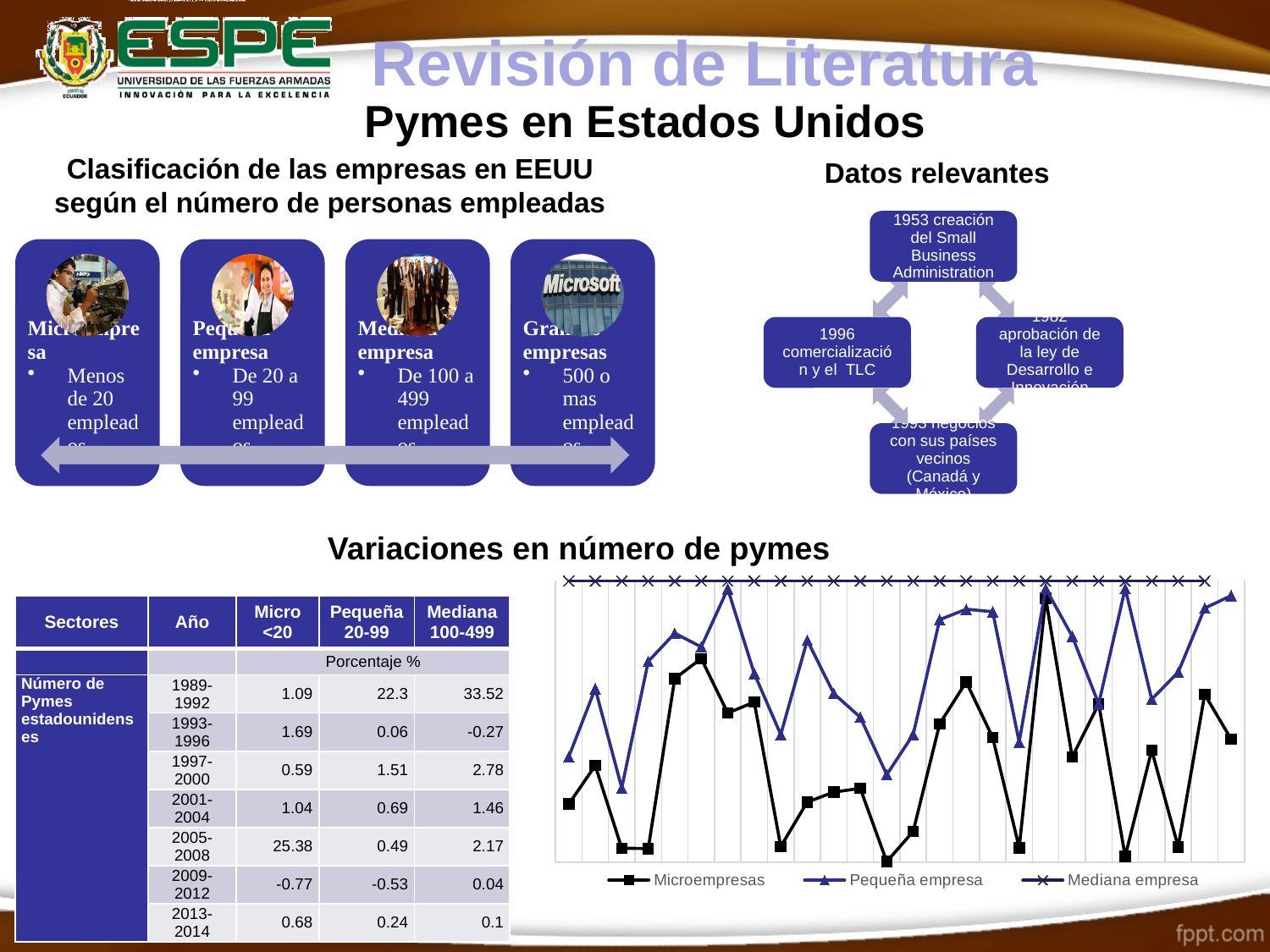
In the 'Variaciones en número de pymes' chart, which series generally lies lowest on the chart? Microempresas What is the first entry in the legend of the 'Variaciones en número de pymes' chart? Microempresas In the 'Variaciones en número de pymes' chart, which series is drawn with triangle markers? Pequeña empresa What kind of chart is shown under the heading 'Variaciones en número de pymes'? line chart How many series does the legend of the 'Variaciones en número de pymes' chart list? 3 In the 'Variaciones en número de pymes' chart, which series is plotted as the flat line along the top of the chart? Mediana empresa